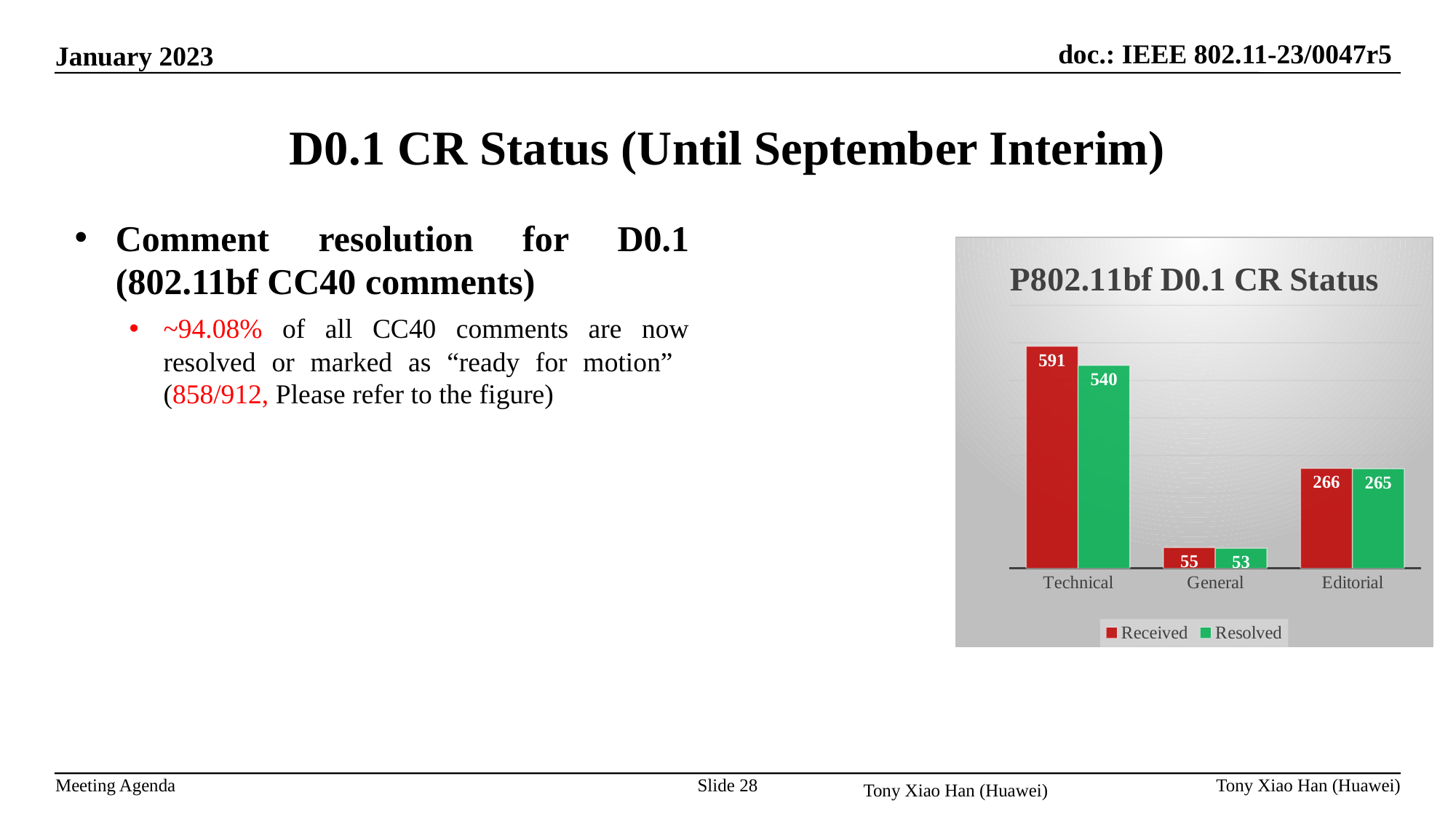
Which is larger, the Resolved value for Technical or the Resolved value for Editorial? Technical What is the Resolved value for General? 53 What is the Resolved value for Editorial? 265 What kind of chart is shown? bar chart What is the difference between the Received values for Editorial and General? 211 Which category has the highest Received value? Technical What is the Received value for Technical? 591 What is the difference between Received and Resolved for Technical? 51 How many series does the legend list? 2 How many categories are shown on the x axis? 3 What is the title of the chart? P802.11bf D0.1 CR Status Which category has the lowest Resolved value? General